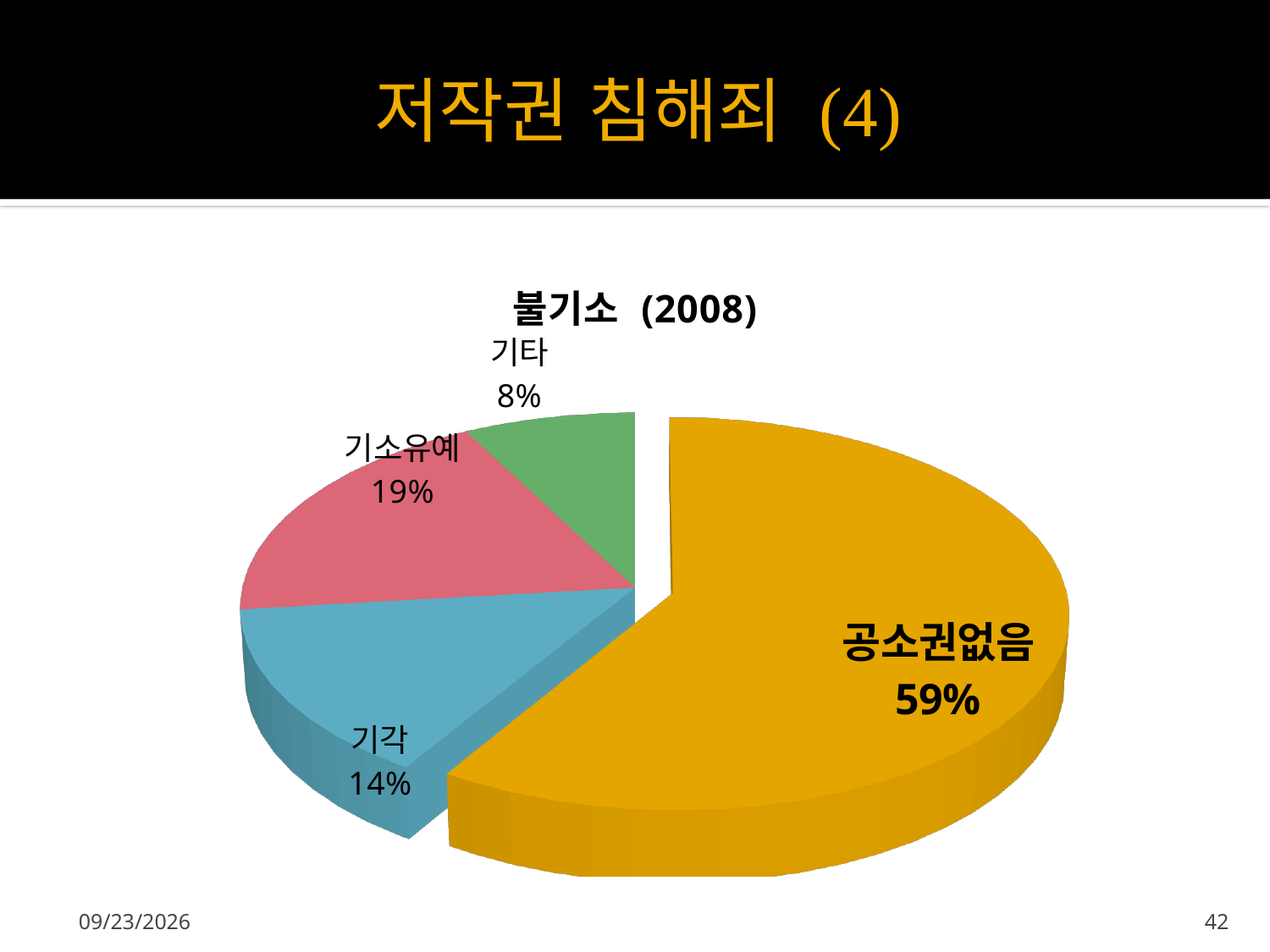
What is the difference in percentage points between 기소유예 and 기각? 5 What is the title of the chart? 불기소 (2008) How many slices does the pie chart have? 4 Which category has the largest share of the pie? 공소권없음 What percentage share does 공소권없음 have in the pie chart? 59% What percentage share does 기각 have in the pie chart? 14% What type of chart is shown on the slide? Pie chart Which category has the smallest share of the pie? 기타 What percentage share does 기소유예 have in the pie chart? 19% What colour is the 공소권없음 slice? Yellow/orange Which is larger, the share for 기소유예 or the share for 기타? 기소유예 What percentage share does 기타 have in the pie chart? 8%